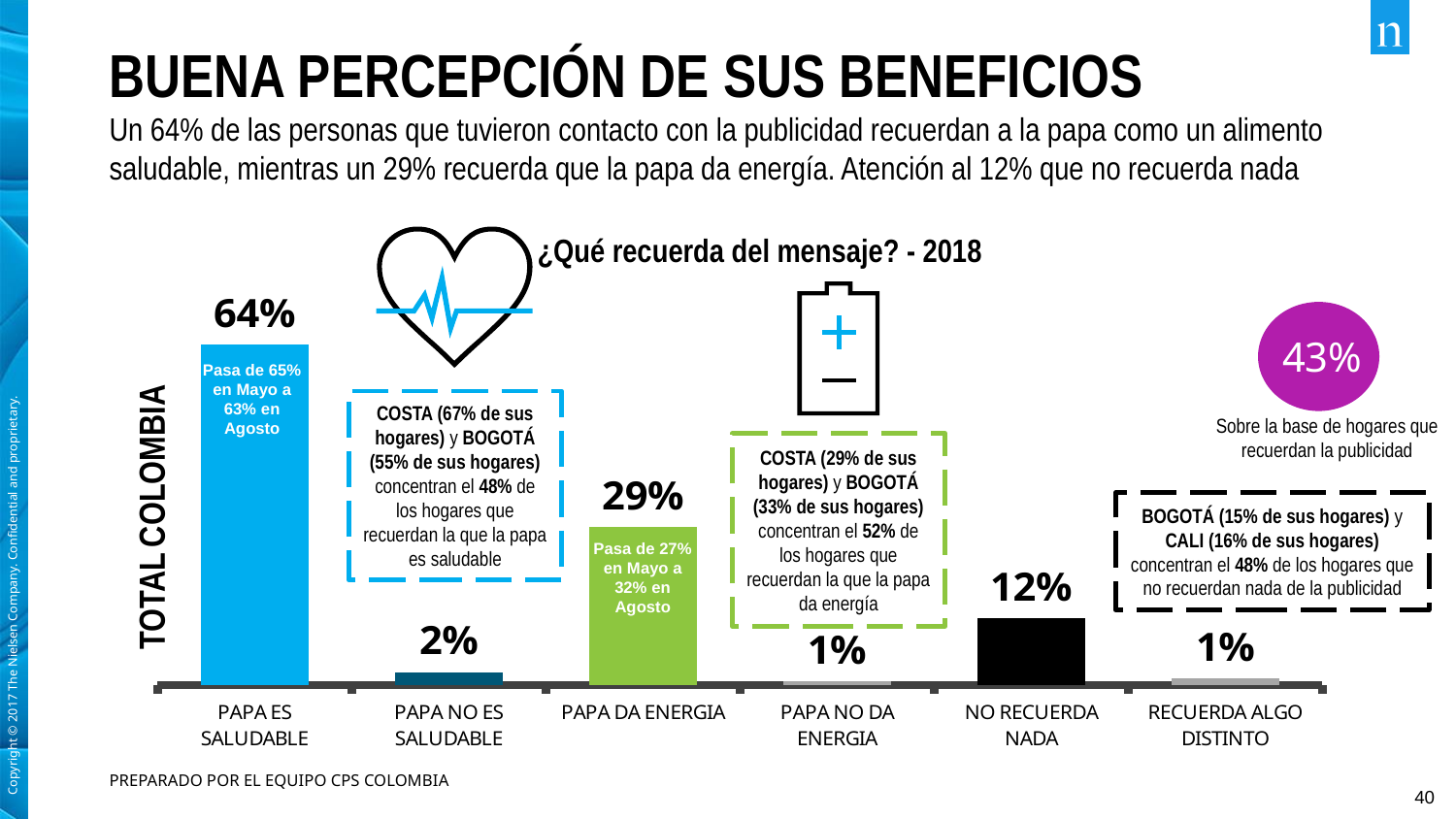
What is the value for PAPA DA ENERGIA? 29% How many categories are shown on the x axis of the chart? 6 What is the label on the vertical axis of the chart? TOTAL COLOMBIA What is the title of the chart? ¿Qué recuerda del mensaje? - 2018 What kind of chart is shown on the slide? Bar chart What is the value for PAPA NO ES SALUDABLE? 2% What is the value for PAPA ES SALUDABLE? 64% What is the value for NO RECUERDA NADA? 12% What is the difference between PAPA DA ENERGIA and NO RECUERDA NADA? 17% Which category has the highest value? PAPA ES SALUDABLE Which is larger, NO RECUERDA NADA or PAPA NO ES SALUDABLE? NO RECUERDA NADA What is the difference between PAPA ES SALUDABLE and PAPA DA ENERGIA? 35%